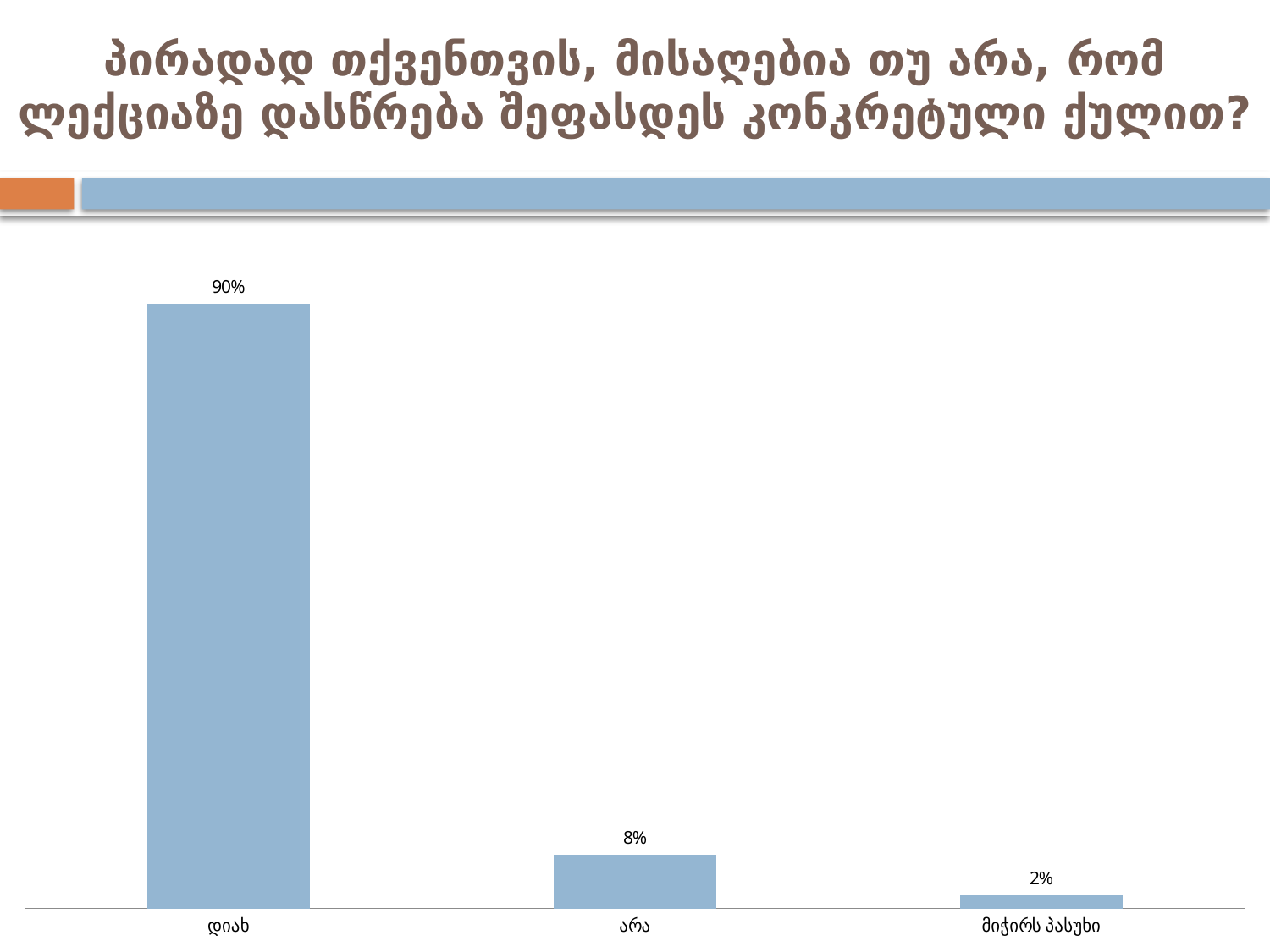
What is the value for დიახ? 90% What is the difference between the values for არა and მიჭირს პასუხი? 6% Which category has the lowest value? მიჭირს პასუხი What colour are the bars in the chart? Light blue Which category has the highest value? დიახ What kind of chart is shown on the slide? Bar chart What is the value for არა? 8% Which is larger, the value for არა or the value for მიჭირს პასუხი? არა What is the difference between the values for დიახ and არა? 82% Do the values rise or fall from left to right across the categories? Fall What is the value for მიჭირს პასუხი? 2% How many categories are shown in the chart? 3